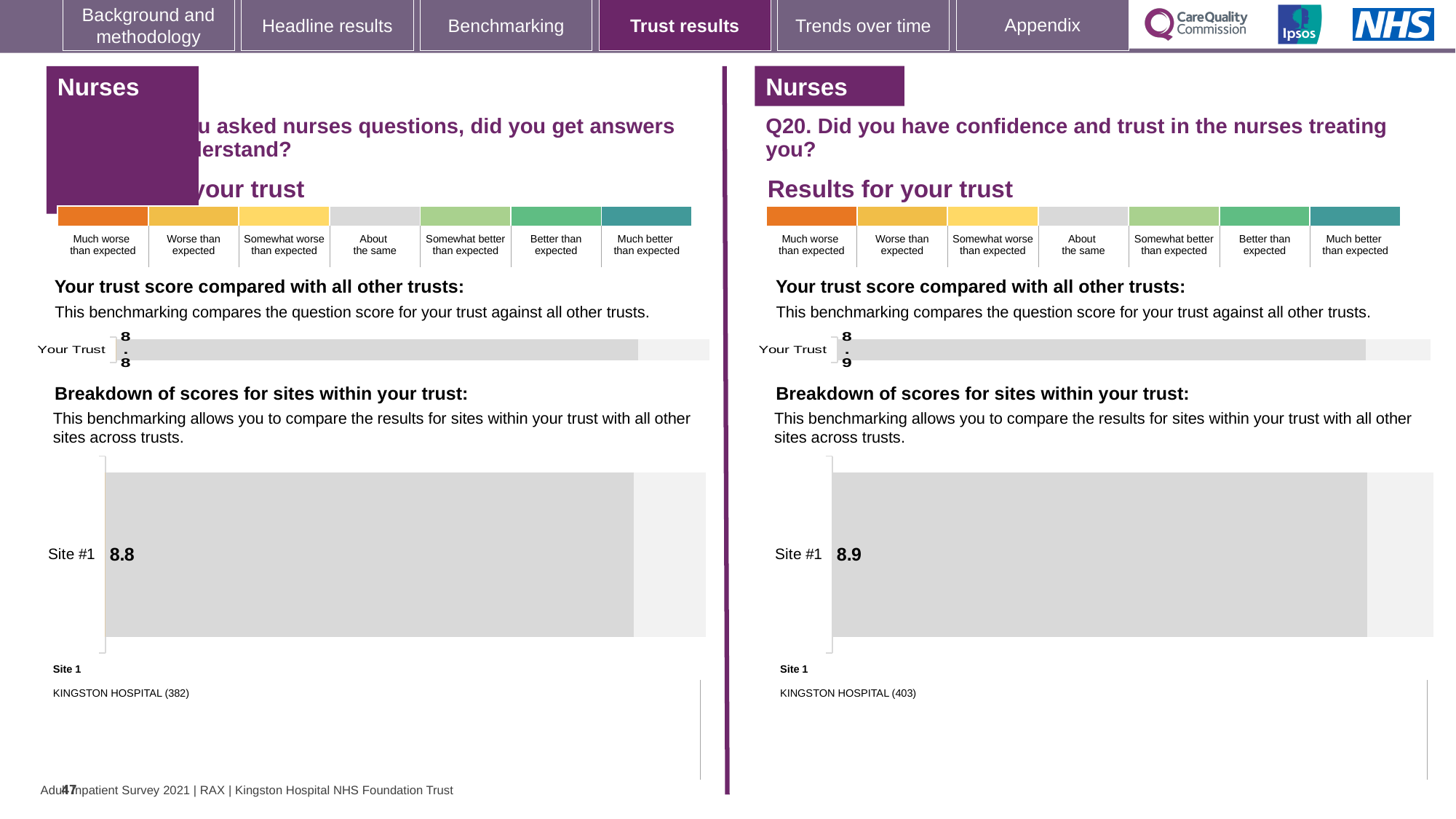
What is the difference between the Site #1 score in the right (Q20) breakdown chart and the Site #1 score in the left breakdown chart? 0.1 On the right half of the slide (Q20), what is the score shown for Your Trust in the 'Your trust score compared with all other trusts' chart? 8.9 How many sites are shown in the right (Q20) 'Breakdown of scores for sites within your trust' chart? 1 Which is larger: the Your Trust score on the left half of the slide or the Your Trust score on the right half (Q20)? Right half (Q20), 8.9 How many sites are shown in the left 'Breakdown of scores for sites within your trust' chart? 1 Which hospital is listed as Site 1 in the right (Q20) breakdown chart, and how many respondents are shown in brackets? KINGSTON HOSPITAL (403) Is the Site #1 score in the right (Q20) breakdown chart greater or less than the Site #1 score in the left breakdown chart? greater What kind of chart is used to show the Your Trust score on the right half of the slide? Bar chart On the left half of the slide, what is the score shown for Your Trust in the 'Your trust score compared with all other trusts' chart? 8.8 In the right 'Breakdown of scores for sites within your trust' chart (Q20), what is the score for Site #1? 8.9 In the left 'Breakdown of scores for sites within your trust' chart, what is the score for Site #1? 8.8 Which hospital is listed as Site 1 in the left breakdown chart, and how many respondents are shown in brackets? KINGSTON HOSPITAL (382)